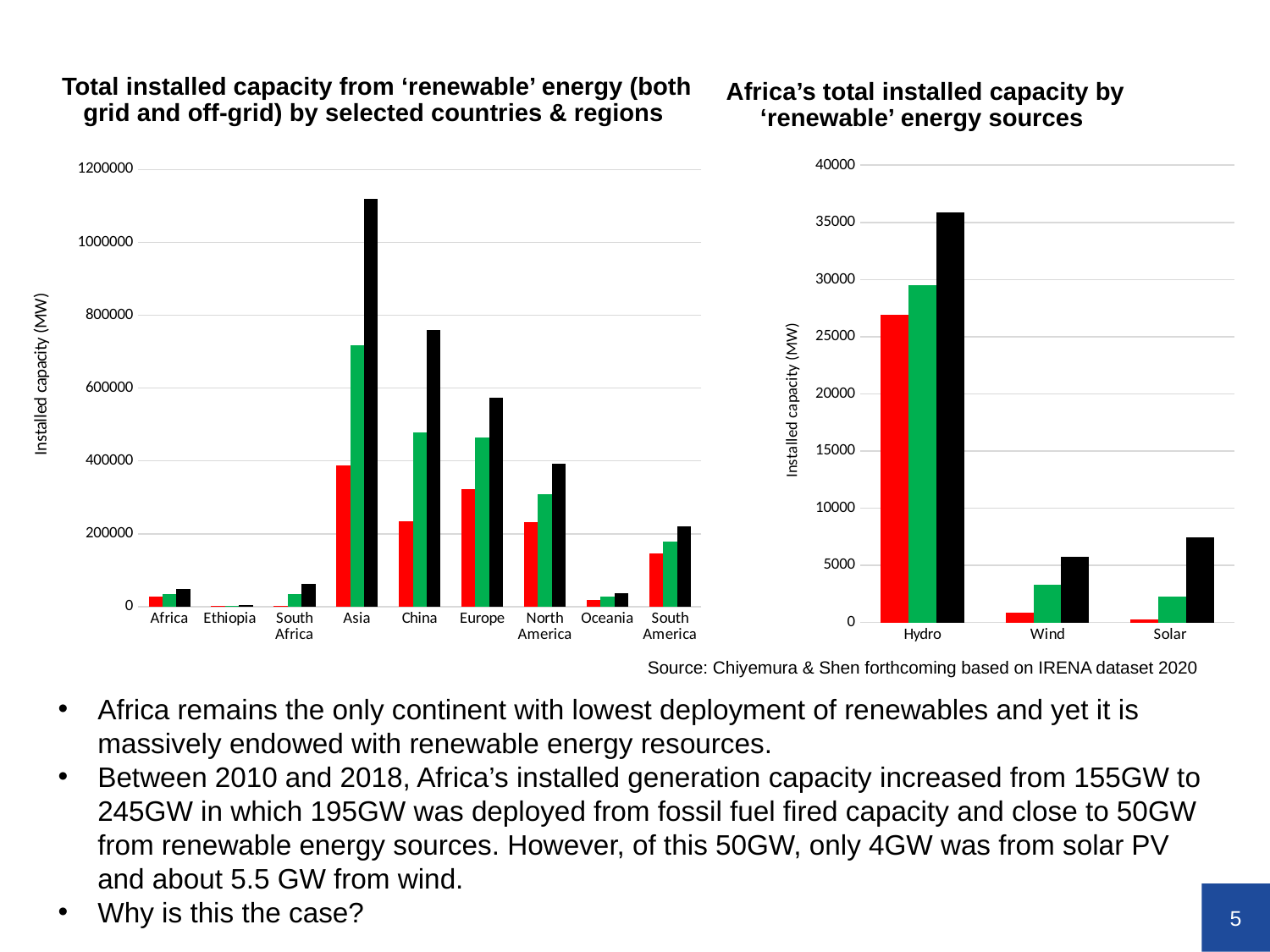
In the left chart, is the tallest bar for Asia greater or less than 1000000? greater In the left chart, which has the larger tallest bar, Europe or North America? Europe In the right chart, which renewable energy source has the highest installed capacity? Hydro How many countries or regions are shown on the x axis of the left chart? 9 How many energy sources are shown on the x axis of the right chart, 'Africa's total installed capacity by renewable energy sources'? 3 What kind of chart is the left chart, 'Total installed capacity from renewable energy by selected countries & regions'? bar chart In the right chart, is the red bar for Hydro greater or less than 25000? greater What is the y-axis label of the right chart? Installed capacity (MW) In the left chart, which country or region has the lowest installed capacity? Ethiopia In the left chart, is the tallest bar for China greater or less than 600000? greater In the left chart, which country or region has the highest installed capacity? Asia